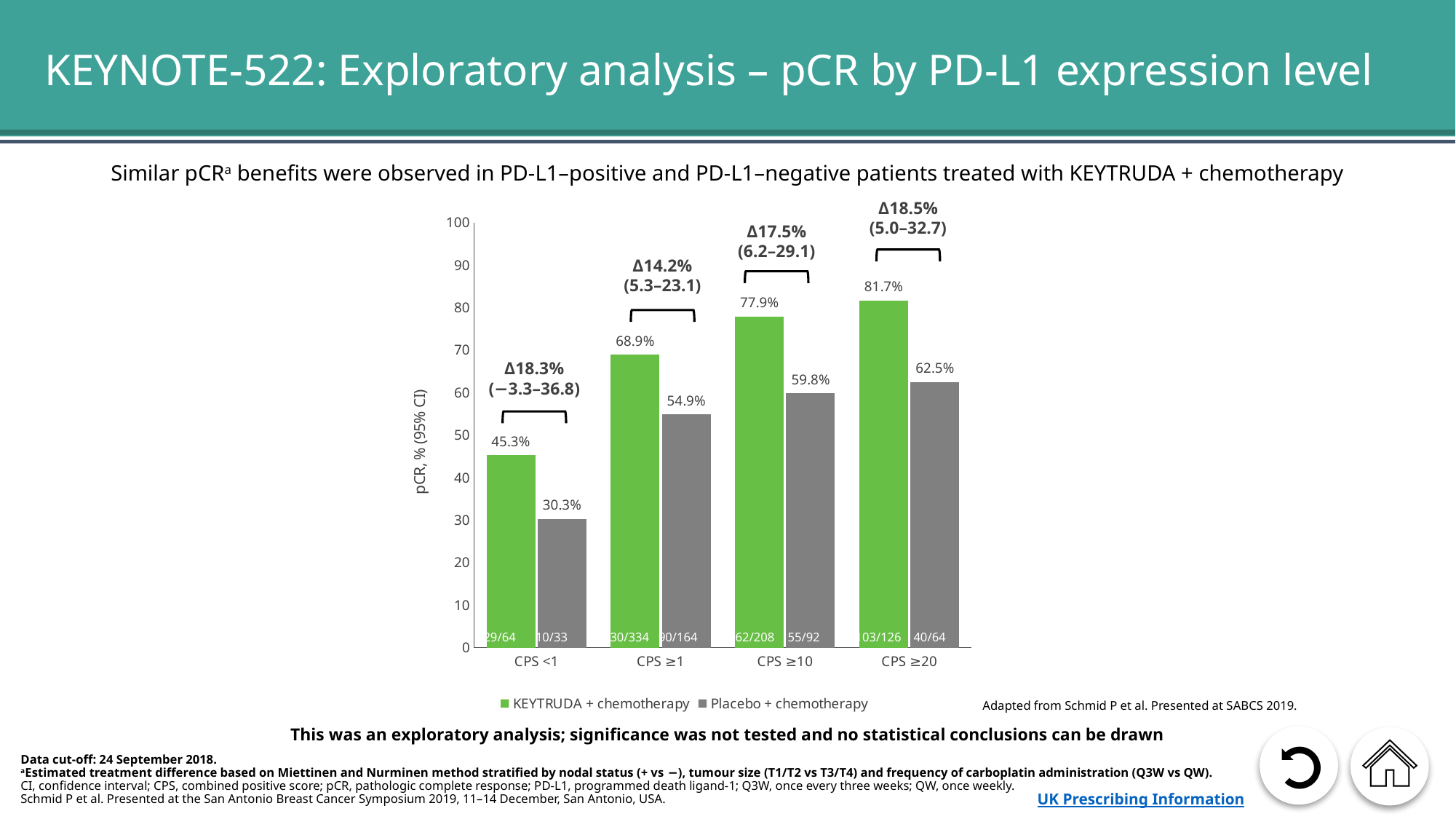
Which is larger in the CPS ≥10 group: the pCR rate for KEYTRUDA + chemotherapy or for Placebo + chemotherapy? KEYTRUDA + chemotherapy Which CPS group has the lowest pCR rate for Placebo + chemotherapy? CPS <1 What is the pCR rate for Placebo + chemotherapy in the CPS ≥1 group? 54.9% What is the pCR rate for KEYTRUDA + chemotherapy in the CPS <1 group? 45.3% What is the pCR rate for KEYTRUDA + chemotherapy in the CPS ≥20 group? 81.7% What is the estimated treatment difference (Δ) shown above the CPS ≥20 bars? Δ18.5% (5.0–32.7) Which CPS group has the highest pCR rate for KEYTRUDA + chemotherapy? CPS ≥20 What is the difference between the KEYTRUDA + chemotherapy and Placebo + chemotherapy pCR rates in the CPS ≥1 group? 14.0% How many series does the legend list? 2 What kind of chart is shown on the slide? Bar chart What is the pCR rate for Placebo + chemotherapy in the CPS ≥10 group? 59.8% How many CPS groups are shown on the x axis? 4